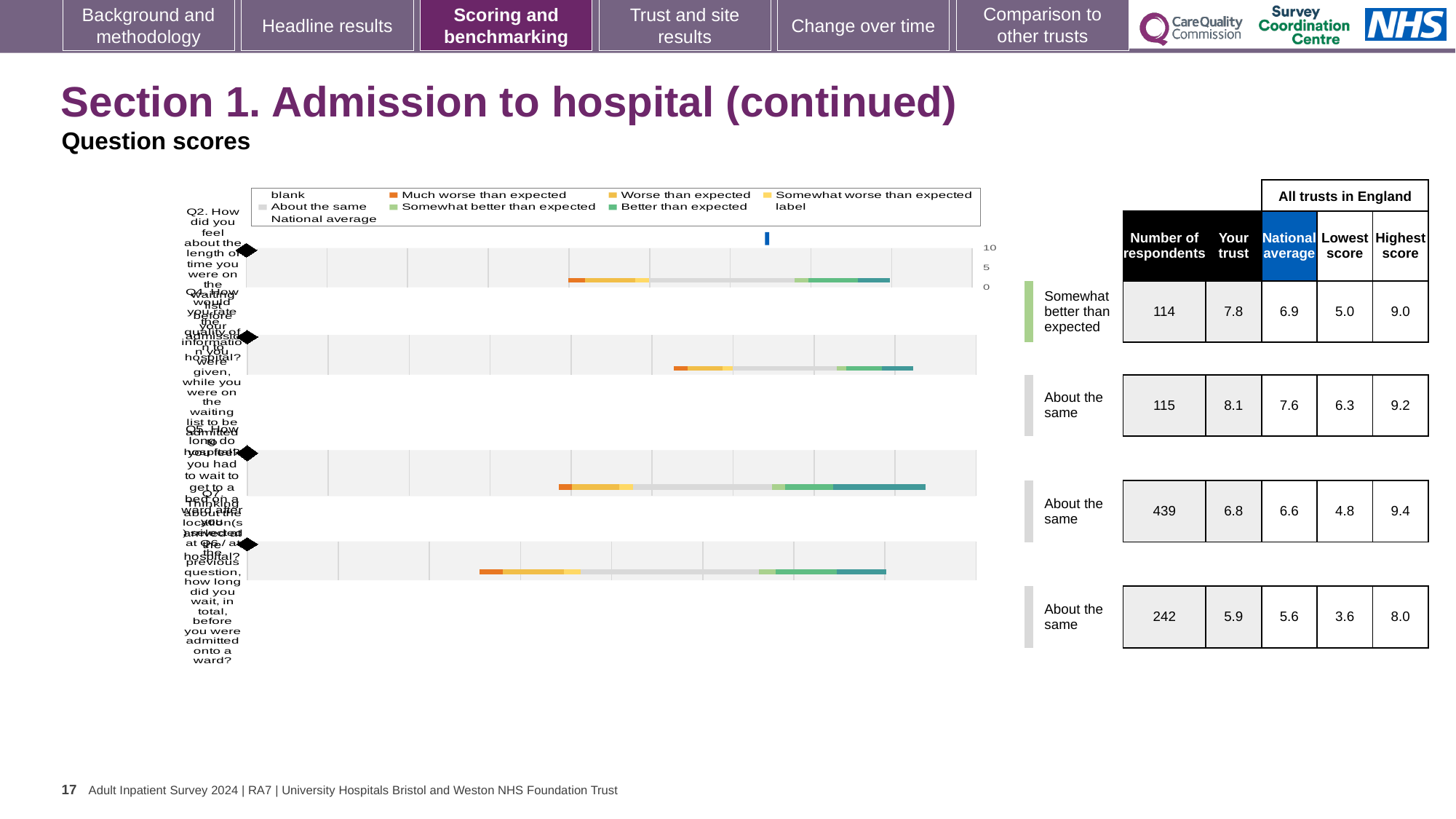
In the table beside the chart, what is the lowest score for the row with 115 respondents? 6.3 How many horizontal bars (question rows) are plotted in the chart? 4 In the table beside the chart, what is the difference between 'Your trust' and the national average for the row with 114 respondents? 0.9 In the table beside the chart, which row has the highest 'Your trust' score? the row with 115 respondents (8.1) In the table beside the chart, for the row with 242 respondents, which is larger: the 'Your trust' score or the national average? Your trust How many entries does the chart legend list? 9 In the chart legend, what colour is used for 'Much worse than expected'? orange In the table beside the chart, what is the highest score for the row with 242 respondents? 8.0 In the table beside the chart, what is the national average for the row with 439 respondents? 6.6 What kind of chart is shown on the slide? bar chart In the table beside the chart, what is the 'Your trust' score for the row with 114 respondents? 7.8 In the chart legend, what colour is used for 'About the same'? light grey